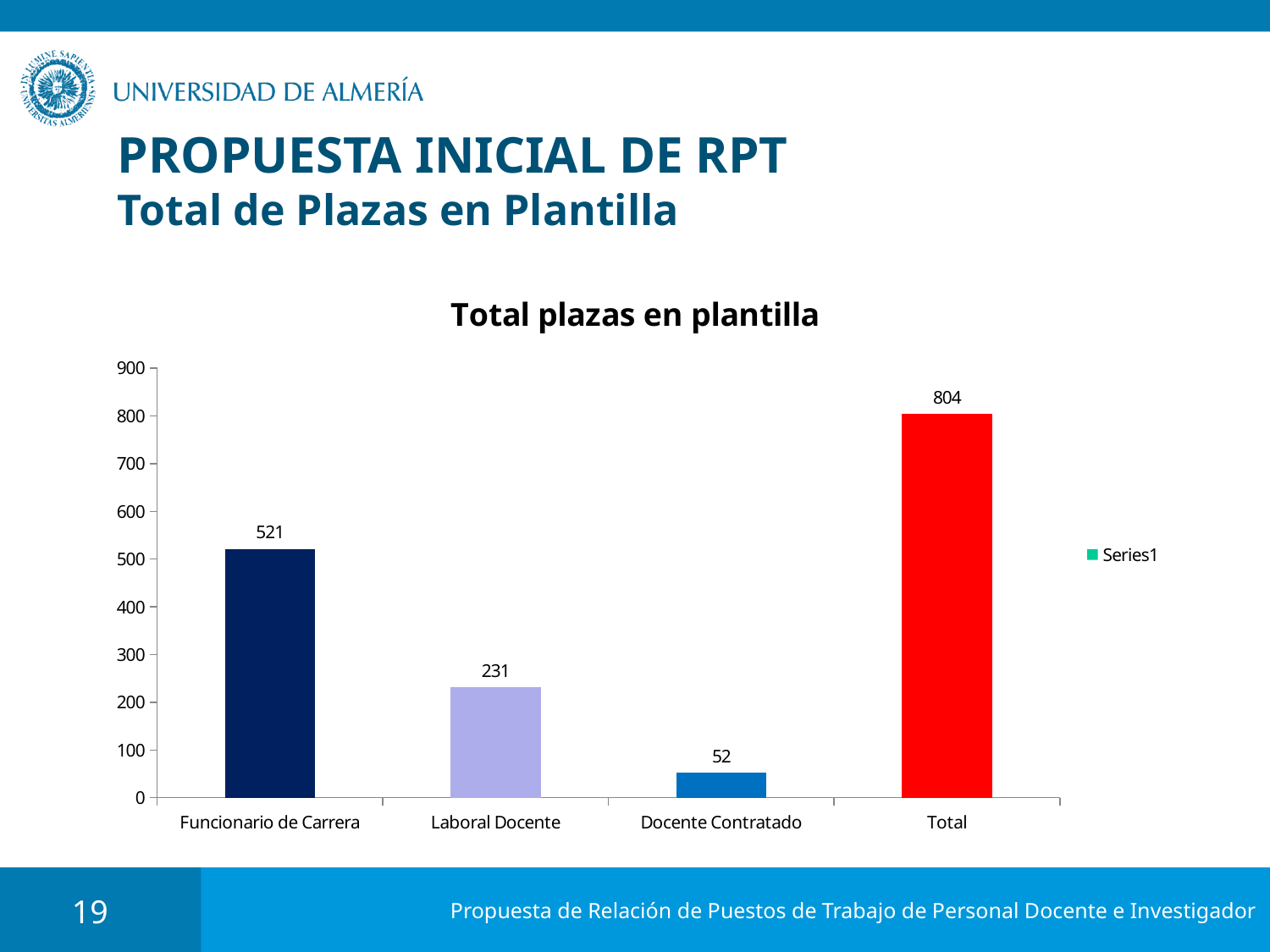
What is the value for Funcionario de Carrera? 521 Which category has the highest value? Total What is the value for Docente Contratado? 52 What is the value for Laboral Docente? 231 How many series does the legend list? 1 What is the difference between the values for Funcionario de Carrera and Laboral Docente? 290 How many categories are shown on the x axis? 4 Which is larger, the value for Laboral Docente or the value for Docente Contratado? Laboral Docente What kind of chart is shown? Bar chart What is the title of the chart? Total plazas en plantilla Which category has the lowest value? Docente Contratado What is the value for Total? 804